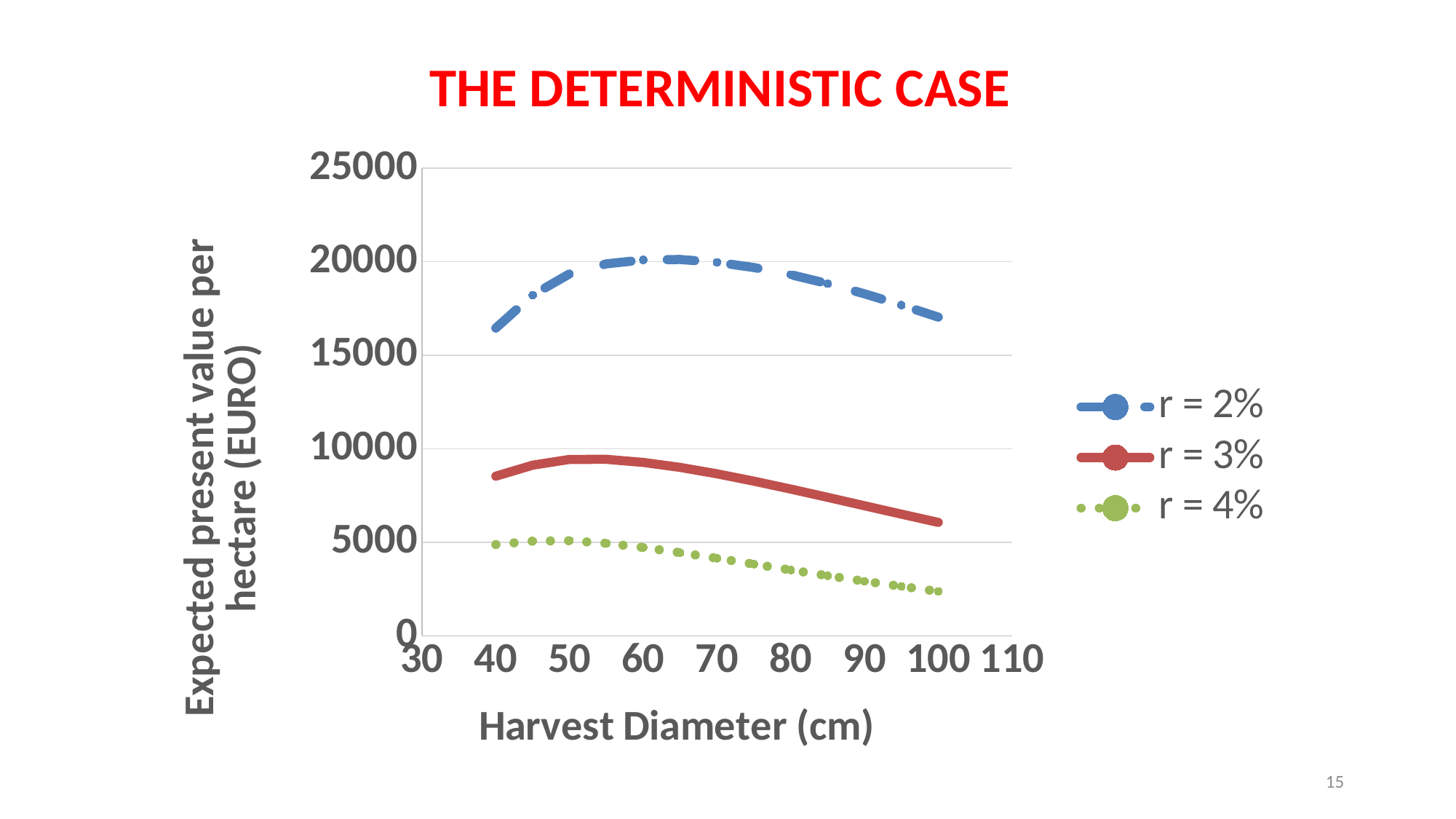
Which series has the highest expected present value across the plotted harvest diameters? r = 2% Is the value for r = 2% at a harvest diameter of 100 cm greater or less than 15000? greater How many series does the legend list? 3 Is the value for r = 3% at a harvest diameter of 40 cm greater or less than 10000? less Which series has the lowest expected present value across the plotted harvest diameters? r = 4% Is the value for r = 2% at a harvest diameter of 40 cm greater or less than 15000? greater What is the label of the x axis? Harvest Diameter (cm) At a harvest diameter of 60 cm, which is larger: the value for r = 2% or the value for r = 3%? r = 2% What kind of chart is shown on the slide? line chart What is the title of the chart? THE DETERMINISTIC CASE Does the value for r = 4% rise or fall as harvest diameter increases from 60 cm to 100 cm? fall